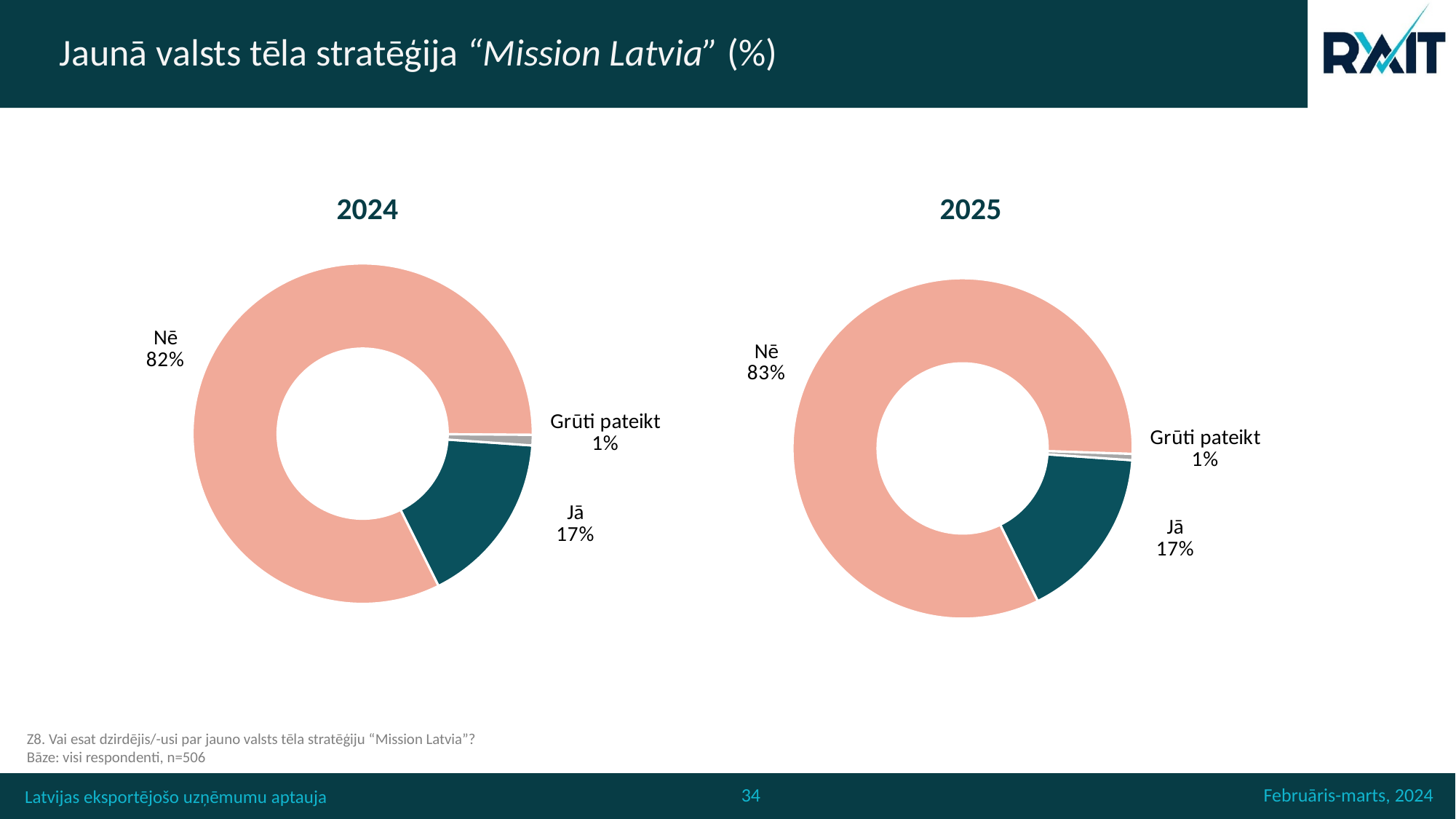
Which is larger: "Nē" in the 2024 chart or "Nē" in the 2025 chart? Nē in 2025 In the 2025 chart, what share of the whole does "Jā" represent? 17% How many categories does the 2025 chart show? 3 What is the title of the chart on the right? 2025 In the 2025 chart, what is the value for "Nē"? 83% In the 2025 chart, which category has the smallest share? Grūti pateikt What kind of chart is the 2024 chart? Doughnut (pie) chart In the 2024 chart, what is the difference between "Nē" and "Jā"? 65 percentage points In the 2024 chart, what is the value for "Jā"? 17% In the 2025 chart, what is the value for "Grūti pateikt"? 1% In the 2024 chart, which category has the largest share? Nē In the 2024 chart, what is the value for "Nē"? 82%